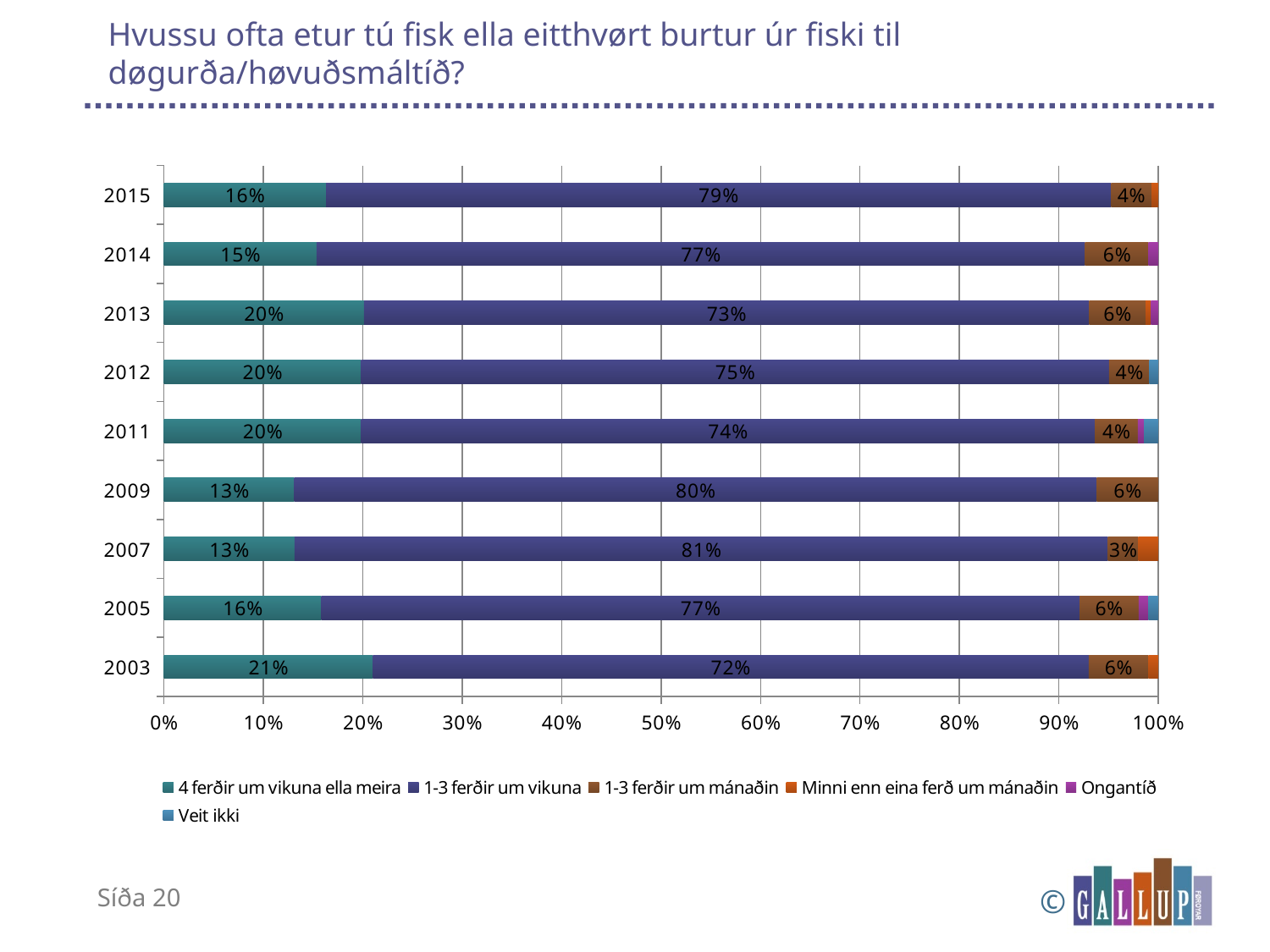
What is the value for '1-3 ferðir um vikuna' in 2015? 79% How many years are shown on the vertical axis? 9 Which is larger: the '1-3 ferðir um vikuna' value for 2015 or for 2014? 2015 How many series does the legend list? 6 In which year is the value for '1-3 ferðir um vikuna' lowest? 2003 What is the value for '1-3 ferðir um mánaðin' in 2007? 3% What is the difference between the '4 ferðir um vikuna ella meira' values for 2003 and 2015? 5 percentage points What is the value for '4 ferðir um vikuna ella meira' in 2014? 15% In which year is the value for '1-3 ferðir um vikuna' highest? 2007 In which year is the value for '4 ferðir um vikuna ella meira' highest? 2003 What is the value for '4 ferðir um vikuna ella meira' in 2003? 21% What kind of chart is shown on the slide? Stacked bar chart